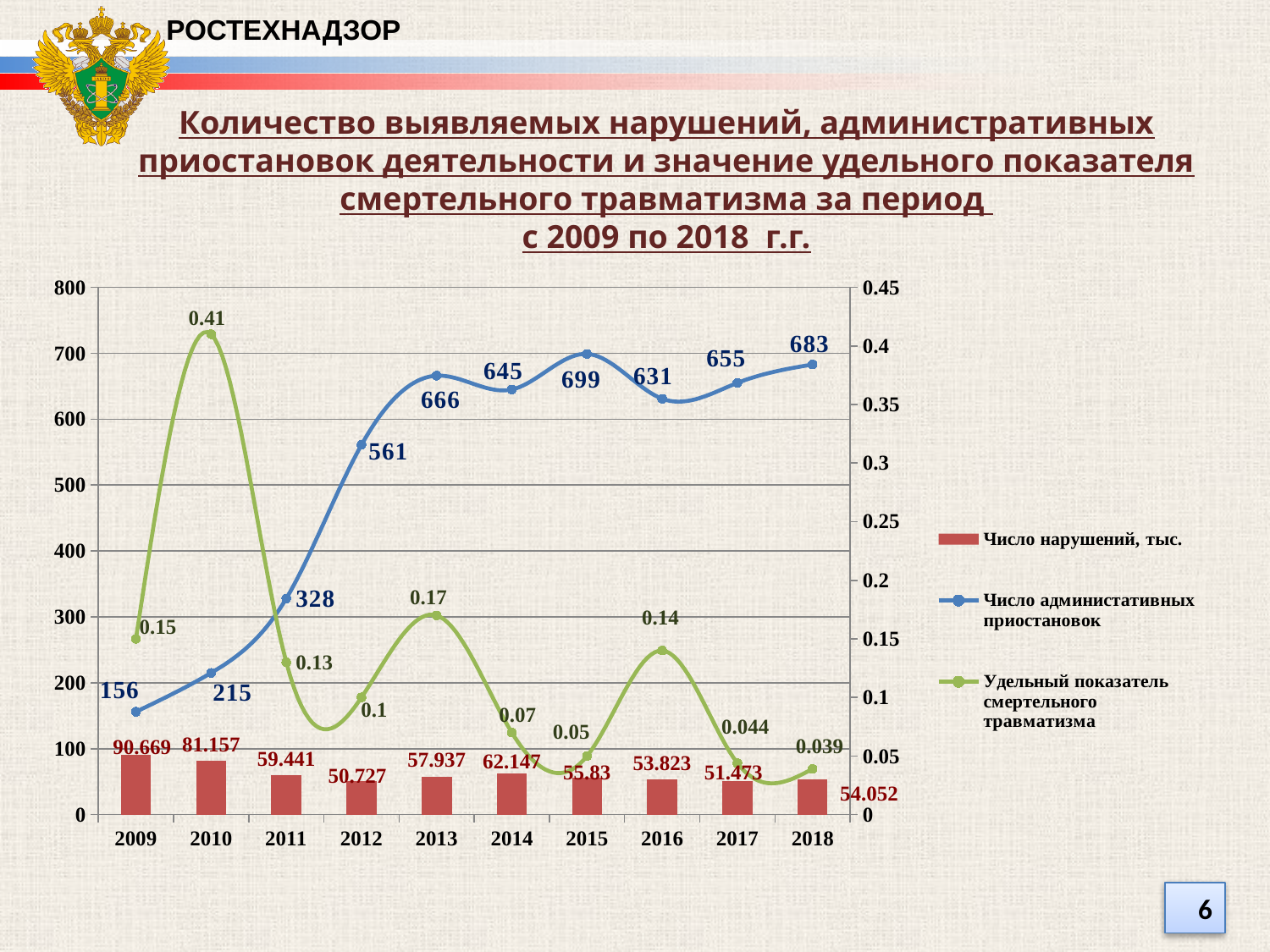
Which is larger: Число административных приостановок in 2013 or in 2014? 2013 How many years are shown on the x axis? 10 What is the value of Удельный показатель смертельного травматизма in 2018? 0.039 What is the difference between Число административных приостановок in 2018 and in 2009? 527 What is the value of Число нарушений, тыс. in 2009? 90.669 How many series does the legend list? 3 In which year is Число нарушений, тыс. the lowest? 2012 What is the value of Число административных приостановок in 2015? 699 In which year is Удельный показатель смертельного травматизма the highest? 2010 What is the value of Удельный показатель смертельного травматизма in 2010? 0.41 In which year is Число административных приостановок the lowest? 2009 Did Число административных приостановок rise or fall from 2009 to 2013? rise